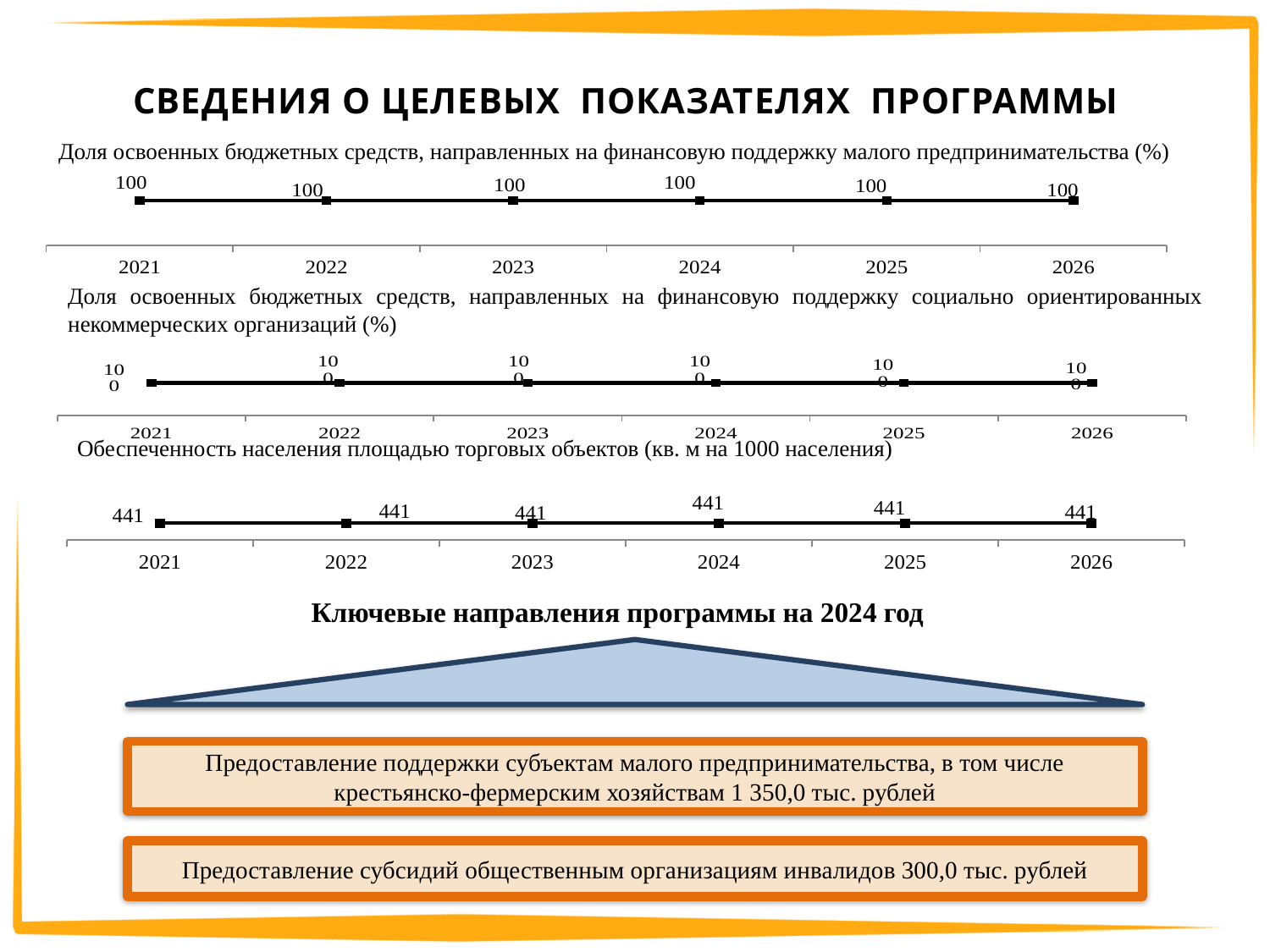
In the top chart (Доля освоенных бюджетных средств, направленных на финансовую поддержку малого предпринимательства), what is the difference between the values for 2024 and 2021? 0 In the bottom chart (Обеспеченность населения площадью торговых объектов), what is the difference between the values for 2026 and 2021? 0 In the top chart (Доля освоенных бюджетных средств, направленных на финансовую поддержку малого предпринимательства), do the values rise, fall or stay flat from 2021 to 2026? stay flat In the bottom chart (Обеспеченность населения площадью торговых объектов), what unit is given in the chart title? кв. м на 1000 населения In the bottom chart (Обеспеченность населения площадью торговых объектов), what is the value for 2026? 441 In the top chart (Доля освоенных бюджетных средств, направленных на финансовую поддержку малого предпринимательства), how many years are plotted on the x axis? 6 In the top chart (Доля освоенных бюджетных средств, направленных на финансовую поддержку малого предпринимательства), what is the value for 2021? 100 What kind of chart is the top chart (Доля освоенных бюджетных средств, направленных на финансовую поддержку малого предпринимательства)? line chart In the bottom chart (Обеспеченность населения площадью торговых объектов), what is the value for 2023? 441 In the middle chart (Доля освоенных бюджетных средств, направленных на финансовую поддержку социально ориентированных некоммерческих организаций), do the values rise, fall or stay flat across the years? stay flat In the top chart (Доля освоенных бюджетных средств, направленных на финансовую поддержку малого предпринимательства), what is the value for 2026? 100 In the middle chart (Доля освоенных бюджетных средств, направленных на финансовую поддержку социально ориентированных некоммерческих организаций), how many years are plotted? 6